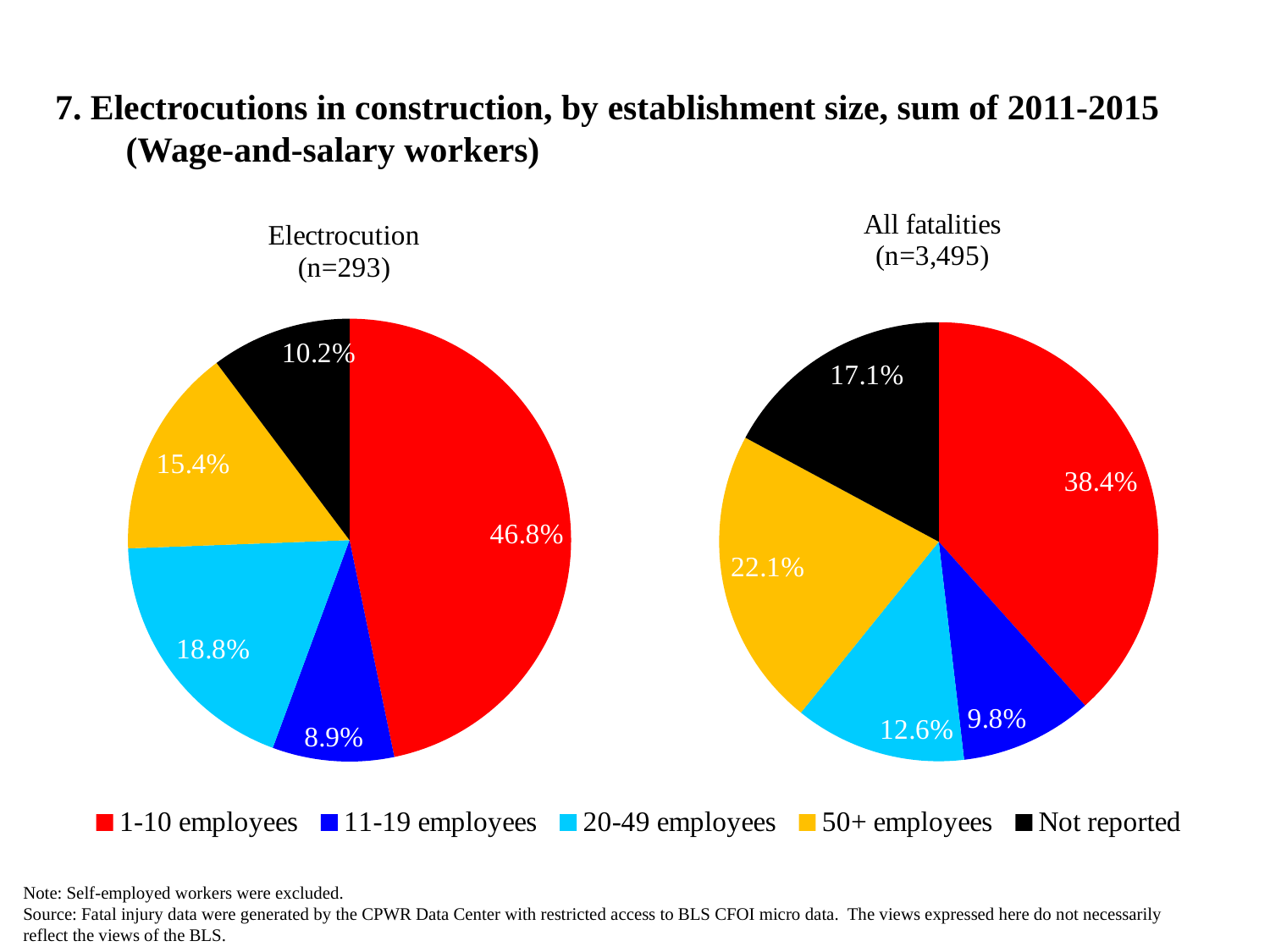
Is the 20-49 employees share larger in the Electrocution chart or in the All fatalities chart? Electrocution In the All fatalities (n=3,495) pie chart, what share is labelled for 11-19 employees? 9.8% In the Electrocution (n=293) pie chart, what share is labelled for Not reported? 10.2% In the Electrocution (n=293) pie chart, which category has the largest slice? 1-10 employees What kind of chart is used on this slide? Pie chart What is the difference between the 1-10 employees share in the Electrocution chart and the 1-10 employees share in the All fatalities chart? 8.4% In the All fatalities (n=3,495) pie chart, which category has the smallest slice? 11-19 employees In the All fatalities (n=3,495) pie chart, what share is labelled for 50+ employees? 22.1% In the Electrocution (n=293) pie chart, what share is labelled for 1-10 employees? 46.8% How many categories does the legend list? 5 Which colour represents 50+ employees in the legend? Yellow In the Electrocution (n=293) pie chart, which category has the smallest slice? 11-19 employees